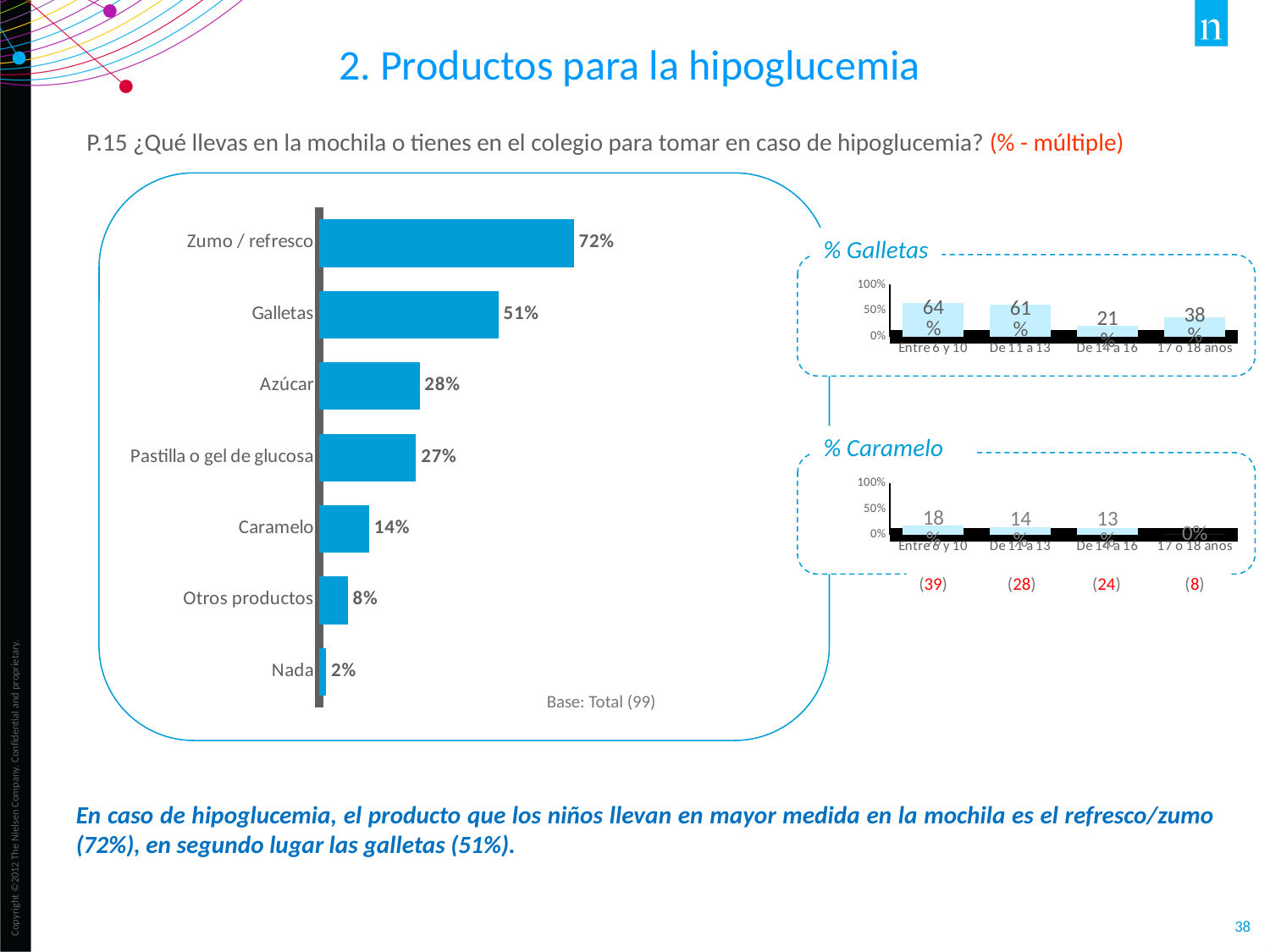
What base size is stated below the main bar chart on the left? Total (99) In the main bar chart on the left, which category has the lowest value? Nada In the main bar chart on the left, what is the difference between the values for Galletas and Azúcar? 23% In the '% Caramelo' chart, what is the value for 17 o 18 años? 0% In the '% Galletas' chart, which age group has the highest value? Entre 6 y 10 In the main bar chart on the left, what is the value for Pastilla o gel de glucosa? 27% In the '% Galletas' chart, what is the value for De 14 a 16? 21% In the main bar chart on the left, how many categories are shown? 7 In the main bar chart on the left, what is the value for Zumo / refresco? 72% In the main bar chart on the left, which category has the highest value? Zumo / refresco In the '% Caramelo' chart, which is larger, the value for Entre 6 y 10 or the value for De 14 a 16? Entre 6 y 10 What kind of chart is the main chart on the left? Bar chart